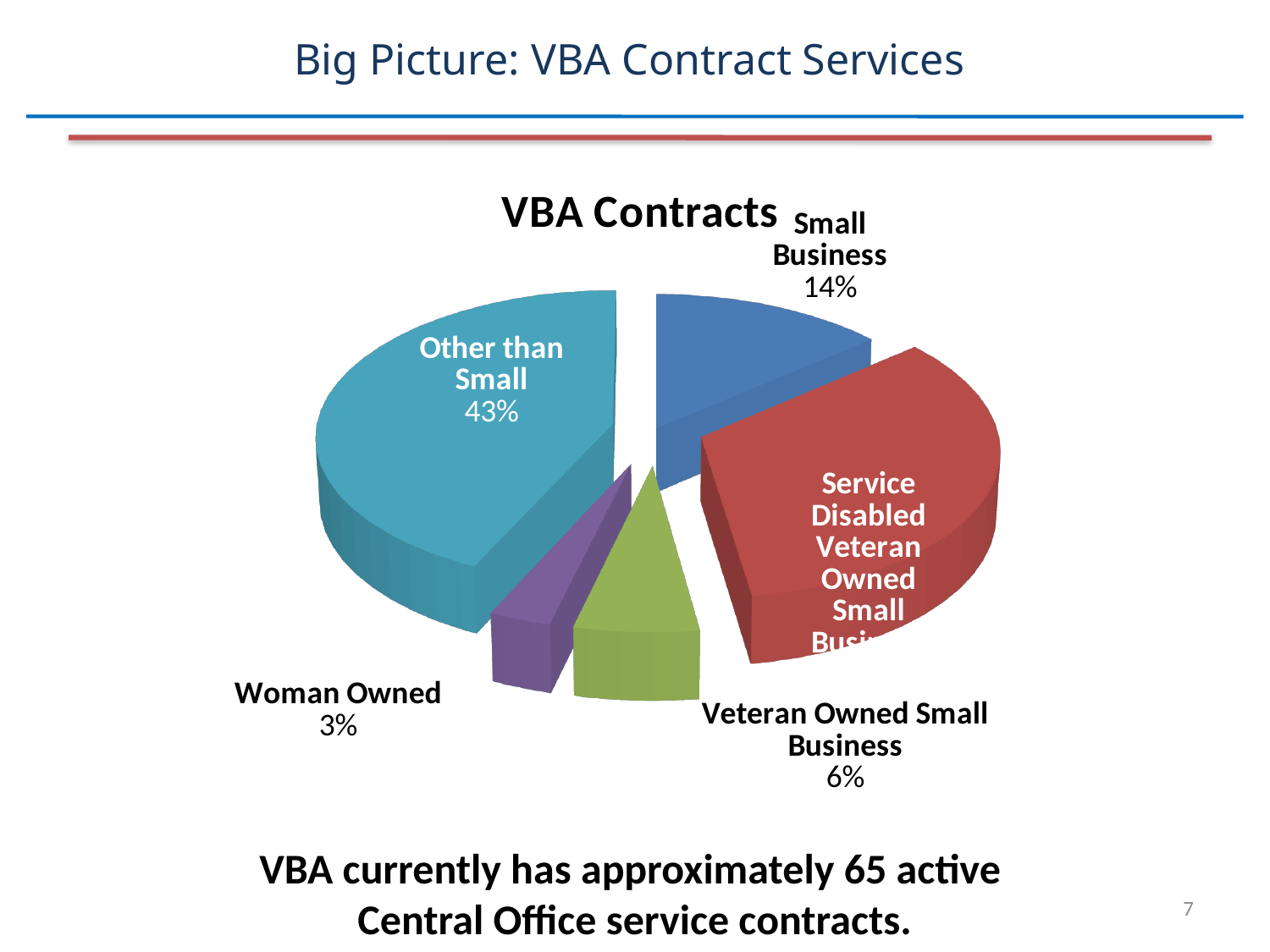
What is the difference in percentage points between Small Business and Veteran Owned Small Business? 8 What percentage of VBA Contracts is Woman Owned? 3% What percentage of VBA Contracts is Veteran Owned Small Business? 6% What is the title of the chart? VBA Contracts What percentage of VBA Contracts is Small Business? 14% How many slices does the pie chart have? 5 Which category has the smallest slice of the pie? Woman Owned What kind of chart is shown on the slide? pie chart Which is larger, the Small Business slice or the Veteran Owned Small Business slice? Small Business What share of VBA Contracts is Other than Small? 43% Which is larger, the Service Disabled Veteran Owned Small Business slice or the Woman Owned slice? Service Disabled Veteran Owned Small Business Which category has the largest slice of the pie? Other than Small